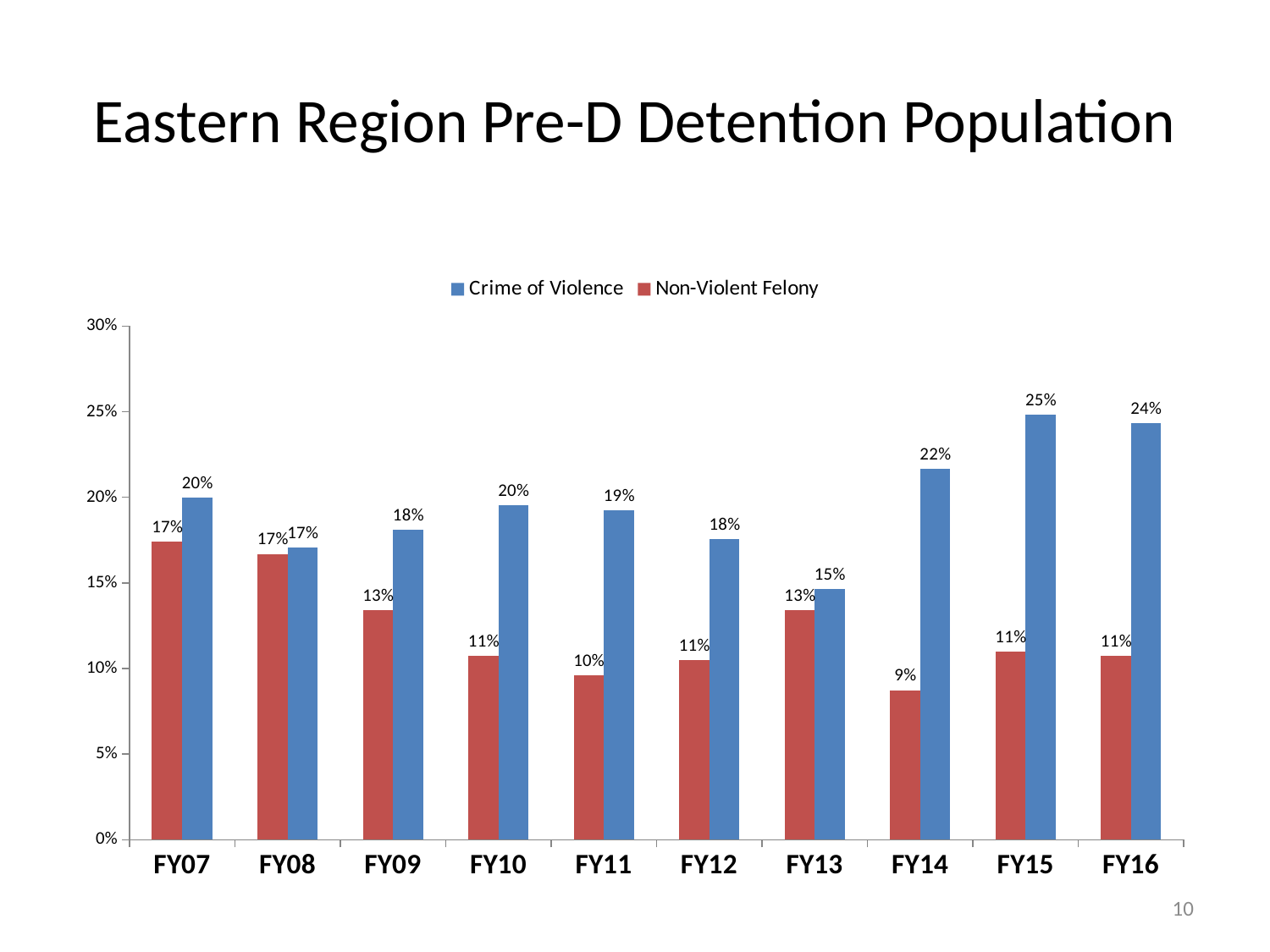
How many fiscal years are shown on the x axis? 10 How many series does the legend list? 2 What is the Crime of Violence value for FY13? 15% What kind of chart is shown on the slide? Bar chart Does the Non-Violent Felony value rise or fall from FY07 to FY11? Fall Which colour represents Non-Violent Felony in the legend? Red In FY10, which is larger: Crime of Violence or Non-Violent Felony? Crime of Violence Which fiscal year has the highest Crime of Violence value? FY15 What is the Non-Violent Felony value for FY14? 9% What is the difference between the Crime of Violence and Non-Violent Felony values in FY14? 13 percentage points What is the Crime of Violence value for FY15? 25% Which fiscal year has the lowest Non-Violent Felony value? FY14